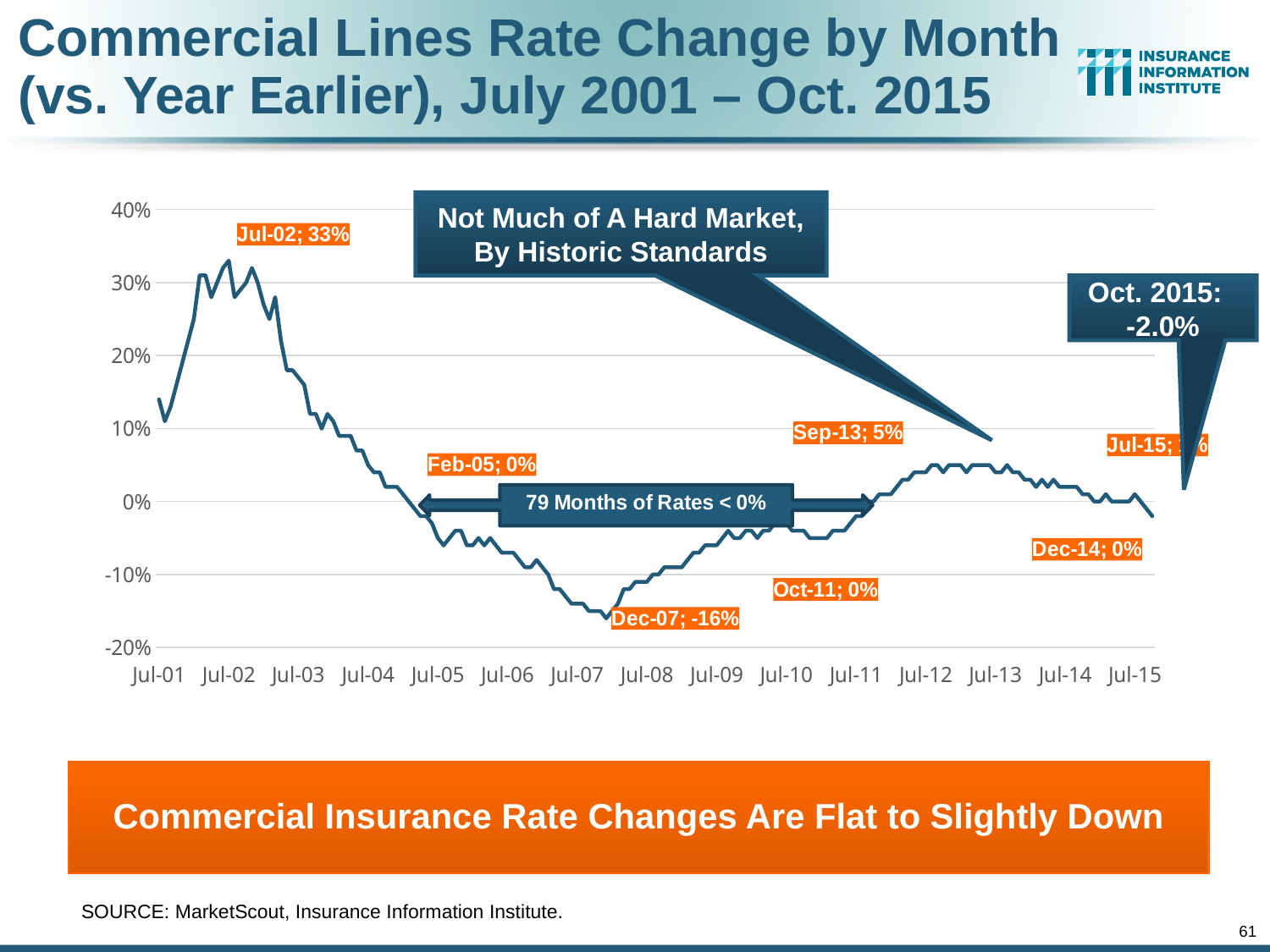
According to the annotation, for how many months were rates below 0%? 79 months Which is larger, the rate change in Sep-13 or in Oct. 2015? Sep-13 What rate change does the callout give for Oct. 2015? -2.0% What is the difference between the Jul-02 value and the Dec-07 value? 49 percentage points Which labeled month has the lowest rate change on the chart? Dec-07 What kind of chart is shown on the slide? Line chart Which labeled month has the highest rate change on the chart? Jul-02 What is the rate change labeled for Sep-13? 5% What is the rate change labeled for Feb-05? 0% Is the value for Jul-13 greater or less than 10%? less What is the rate change labeled for Dec-07? -16% What is the commercial lines rate change labeled for Jul-02? 33%